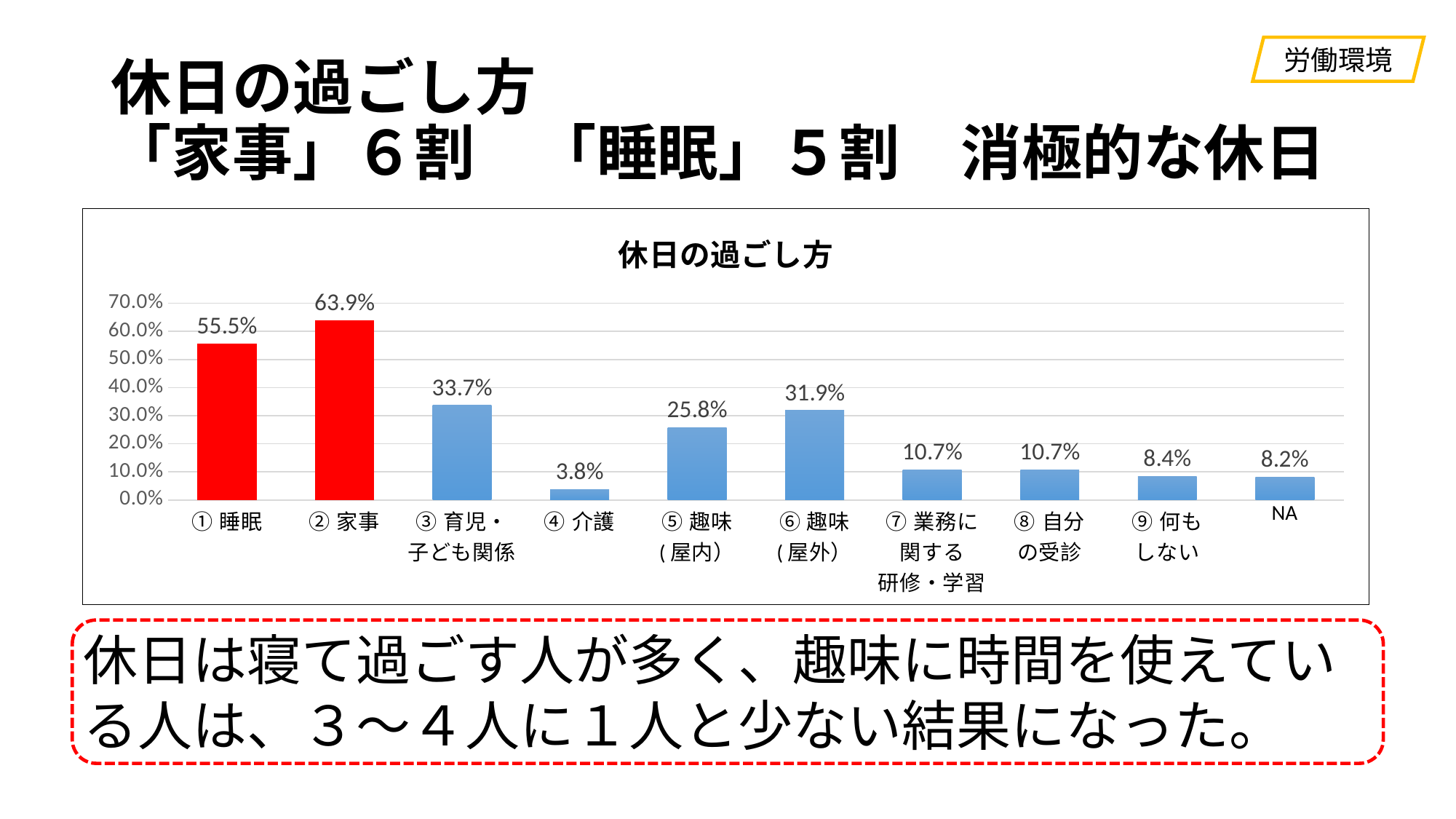
What is the value for ⑥ 趣味（屋外）? 31.9% Which category has the highest value? ② 家事 Which category has the lowest value? ④ 介護 What is the value for ① 睡眠? 55.5% How many categories are shown on the x axis? 10 What is the title of the chart? 休日の過ごし方 What is the value for ④ 介護? 3.8% What kind of chart is this? Bar chart Which bars are coloured red? ① 睡眠 and ② 家事 Which is larger, ③ 育児・子ども関係 or ⑥ 趣味（屋外）? ③ 育児・子ども関係 What is the value for ② 家事? 63.9% What is the difference between ② 家事 and ① 睡眠? 8.4%